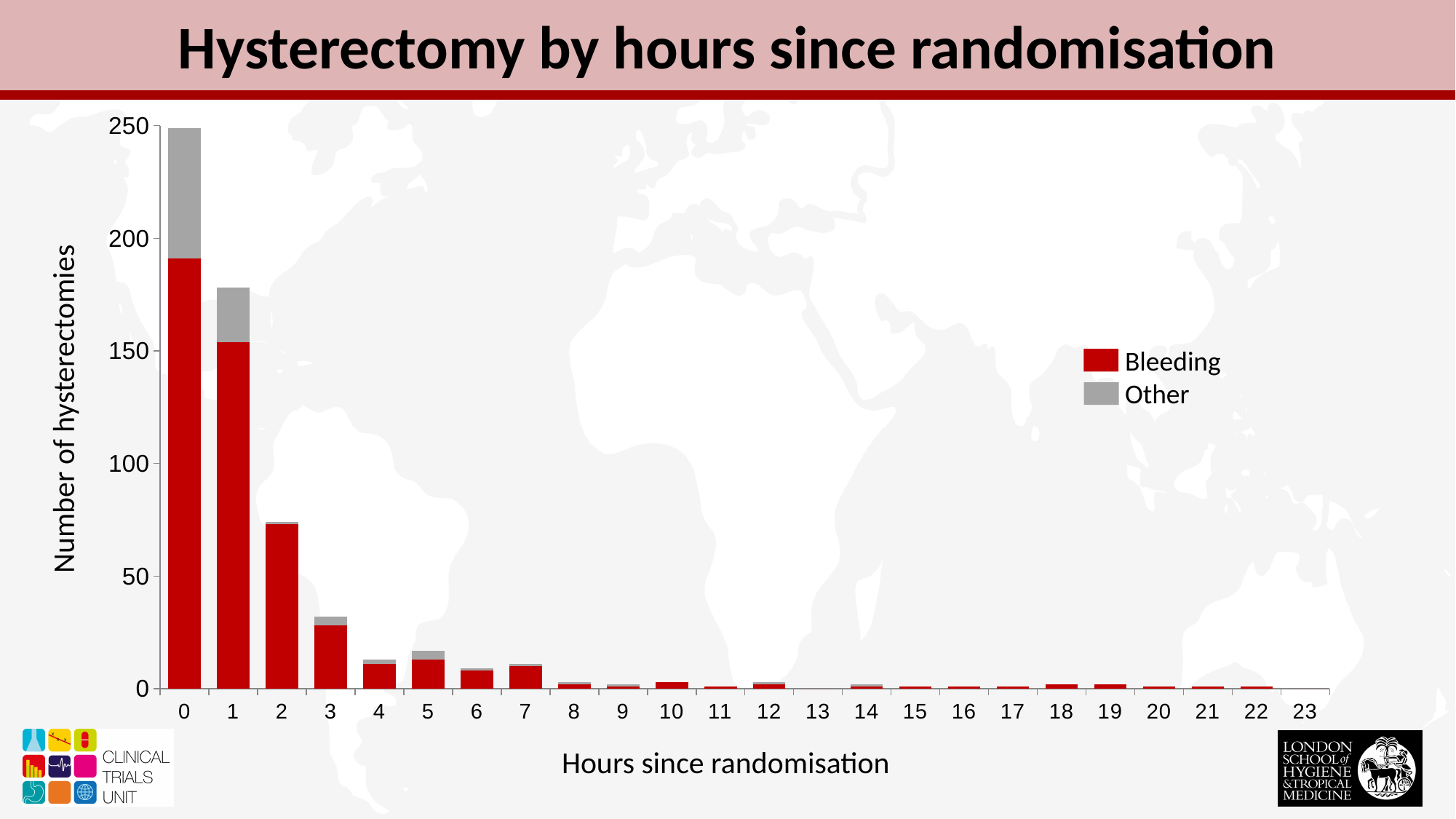
What kind of chart is shown on the slide? Stacked bar chart Do the total number of hysterectomies generally rise or fall as hours since randomisation increase? Fall Is the total number of hysterectomies at hour 0 greater or less than 200? greater Which hour since randomisation has the highest total number of hysterectomies? 0 What are the two series named in the legend? Bleeding and Other Which has more total hysterectomies, hour 0 or hour 1? Hour 0 Is the total number of hysterectomies at hour 2 greater or less than 100? less What is the label of the y axis? Number of hysterectomies How many hour categories are shown on the x axis? 24 Is the number of Bleeding hysterectomies at hour 0 greater or less than 150? greater How many series does the legend list? 2